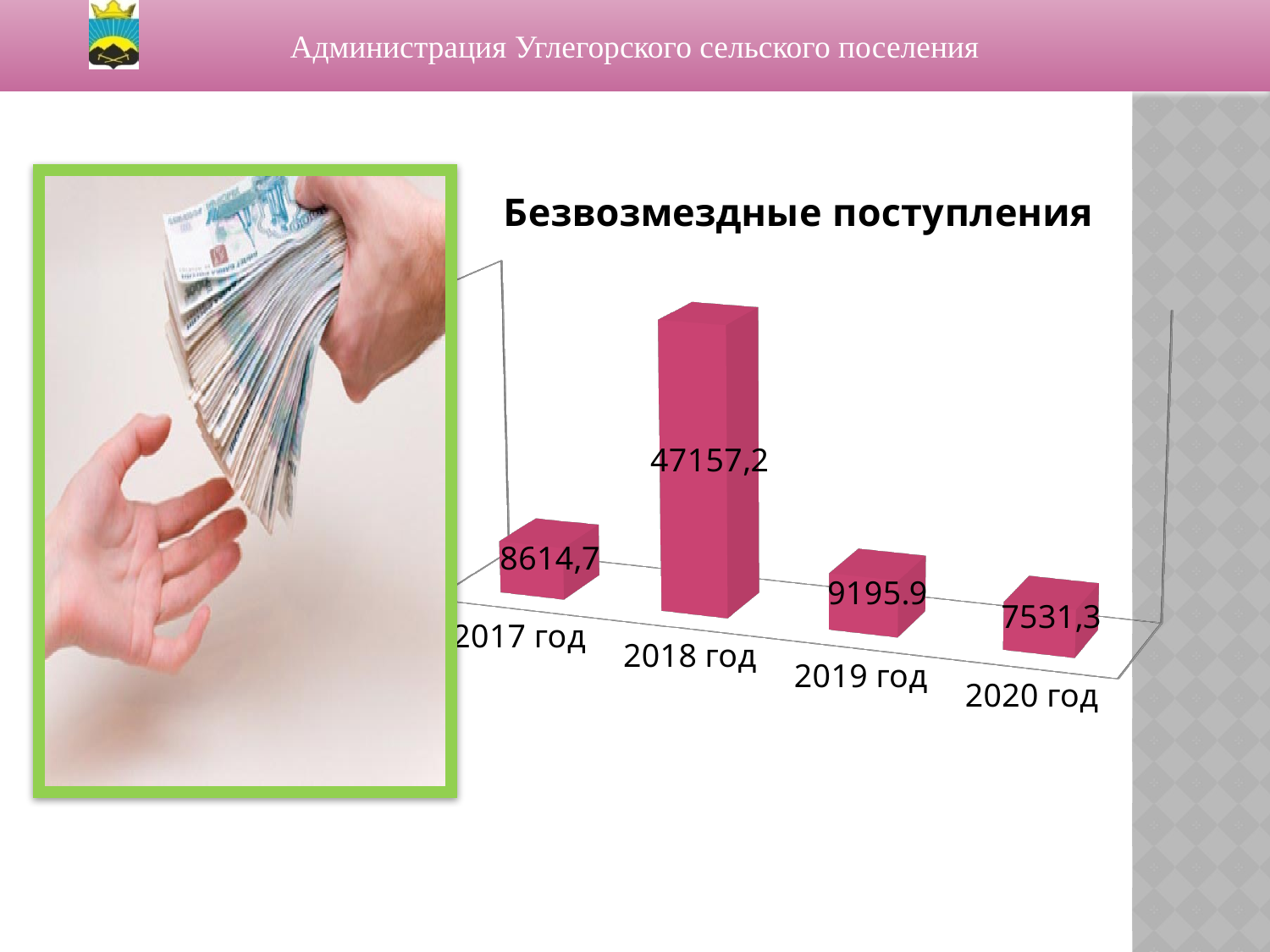
What is the value for 2019 год in the Безвозмездные поступления chart? 9195.9 Which is larger in the Безвозмездные поступления chart, the value for 2019 год or 2017 год? 2019 год Do the values in the Безвозмездные поступления chart rise or fall from 2018 год to 2020 год? Fall What is the difference between the values for 2018 год and 2020 год in the Безвозмездные поступления chart? 39625,9 What is the value for 2020 год in the Безвозмездные поступления chart? 7531,3 How many years are shown in the Безвозмездные поступления chart? 4 Which year has the highest value in the Безвозмездные поступления chart? 2018 год What is the value for 2017 год in the Безвозмездные поступления chart? 8614,7 What kind of chart is used for Безвозмездные поступления? Bar chart What is the difference between the values for 2018 год and 2017 год in the Безвозмездные поступления chart? 38542,5 What is the value for 2018 год in the Безвозмездные поступления chart? 47157,2 Which year has the lowest value in the Безвозмездные поступления chart? 2020 год